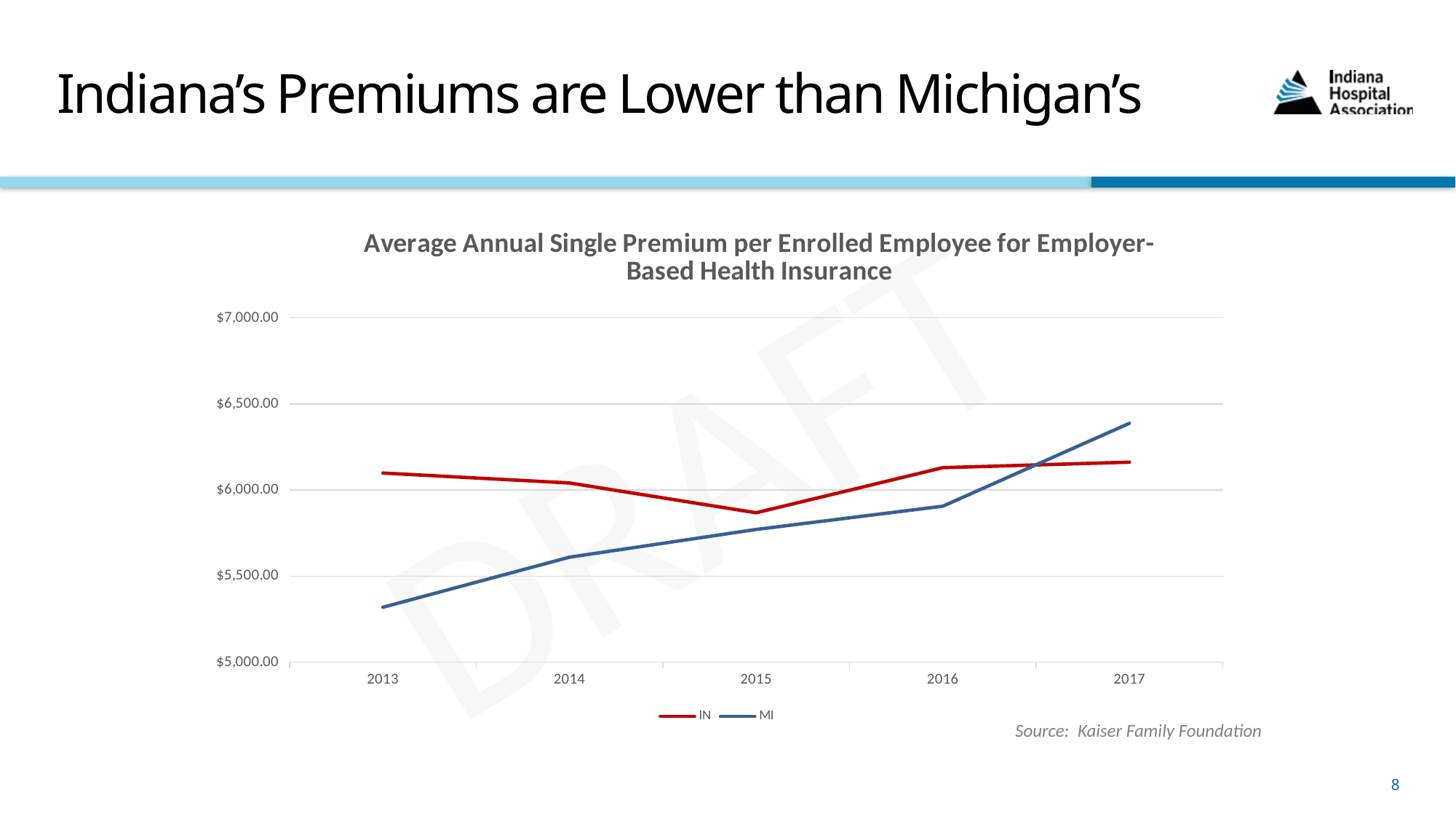
Is the value for IN in 2013 greater or less than $6,000.00? greater What is the title of the chart? Average Annual Single Premium per Enrolled Employee for Employer-Based Health Insurance How many years are plotted on the x axis? 5 Is the value for MI in 2017 greater or less than $6,000.00? greater In which year is the IN value lowest? 2015 What kind of chart is shown on the slide? line chart Which series has the higher value in 2013, IN or MI? IN Which series has the higher value in 2017, IN or MI? MI Is the value for IN in 2015 greater or less than $6,000.00? less How many series does the legend list? 2 Does the MI line rise or fall from 2013 to 2017? rise